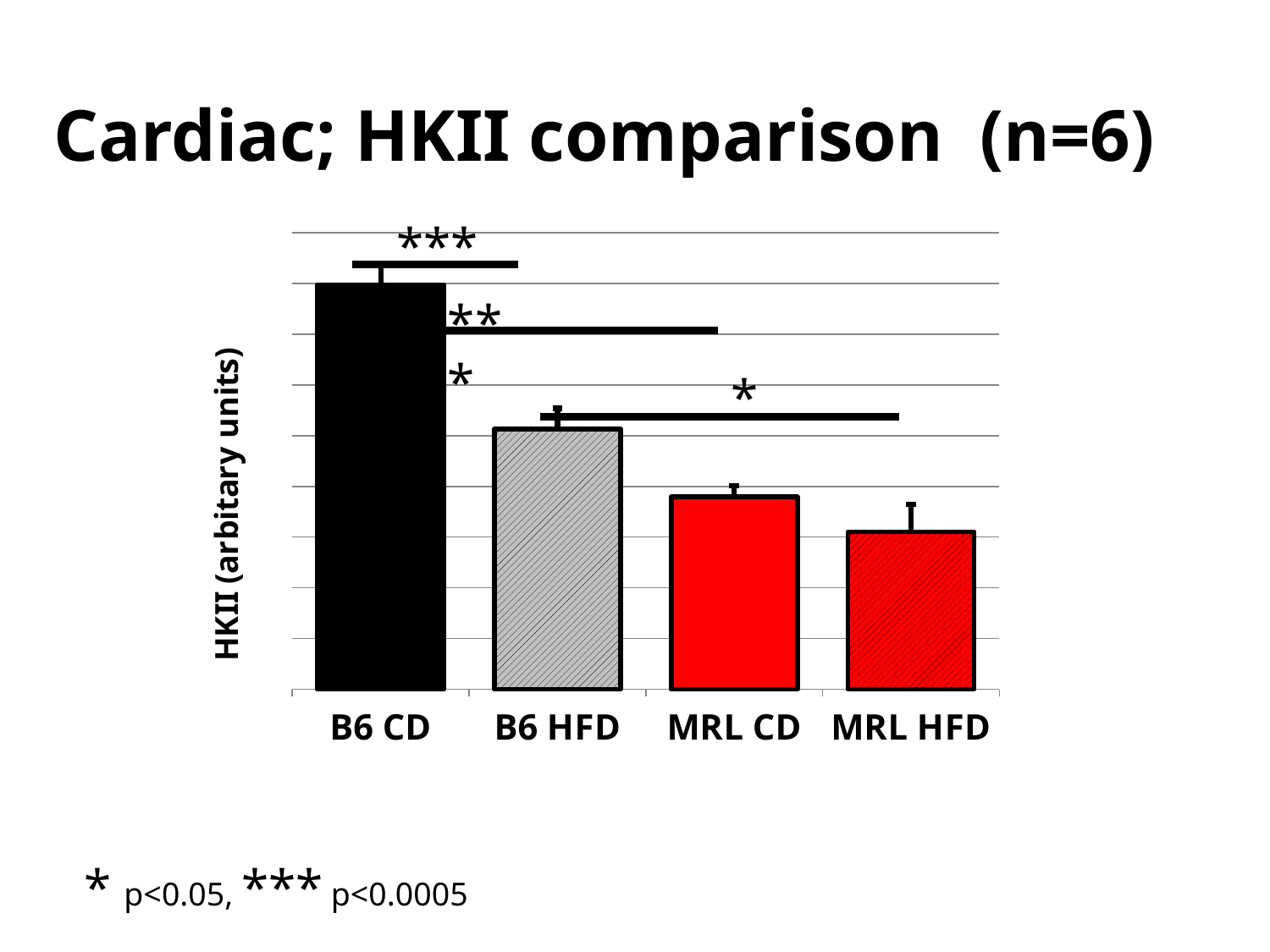
Which category has the lowest HKII value? MRL HFD Which is larger, the value for B6 CD or the value for B6 HFD? B6 CD Which category has the highest HKII value? B6 CD Which is larger, the value for B6 HFD or the value for MRL CD? B6 HFD Do the bar values rise or fall from left to right along the x axis? fall How many categories are plotted on the x axis? 4 What kind of chart is shown on the slide? bar chart What is the label of the y axis? HKII (arbitary units) What is the title of the slide? Cardiac; HKII comparison (n=6) Which is larger, the value for MRL CD or the value for MRL HFD? MRL CD